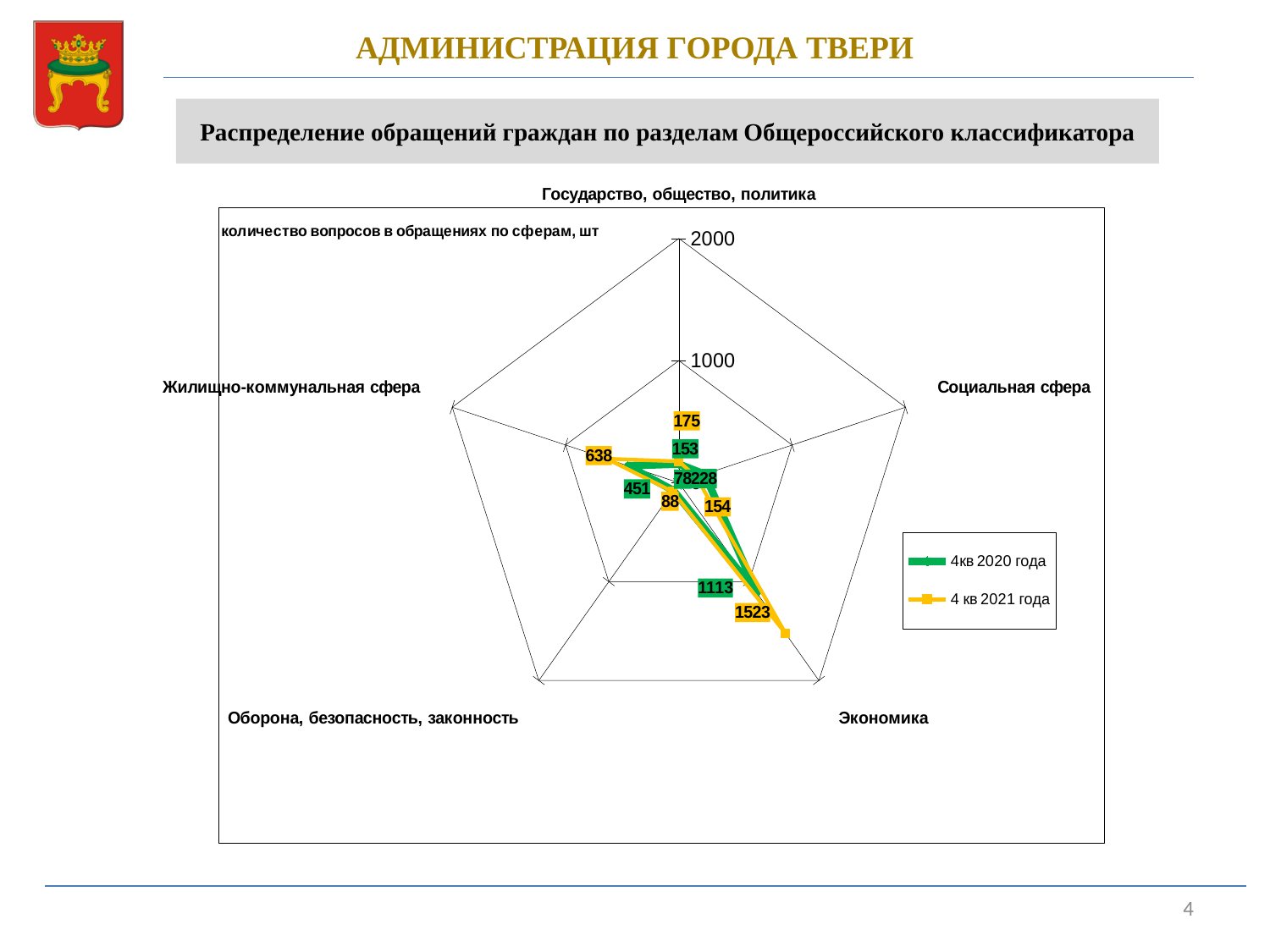
What is the value for Жилищно-коммунальная сфера in 4кв 2020 года? 451 What is the value for Жилищно-коммунальная сфера in 4 кв 2021 года? 638 What is the title of the chart? количество вопросов в обращениях по сферам, шт How many categories (axes) does the radar chart have? 5 How many series does the legend list? 2 Which is larger for Жилищно-коммунальная сфера: the 4кв 2020 года value or the 4 кв 2021 года value? 4 кв 2021 года What is the value for Экономика in 4 кв 2021 года? 1523 What is the value for Экономика in 4кв 2020 года? 1113 What is the difference between the 4 кв 2021 года and 4кв 2020 года values for Экономика? 410 What is the value for Государство, общество, политика in 4 кв 2021 года? 175 What kind of chart is shown on the slide? radar chart Which category has the highest value in 4 кв 2021 года? Экономика